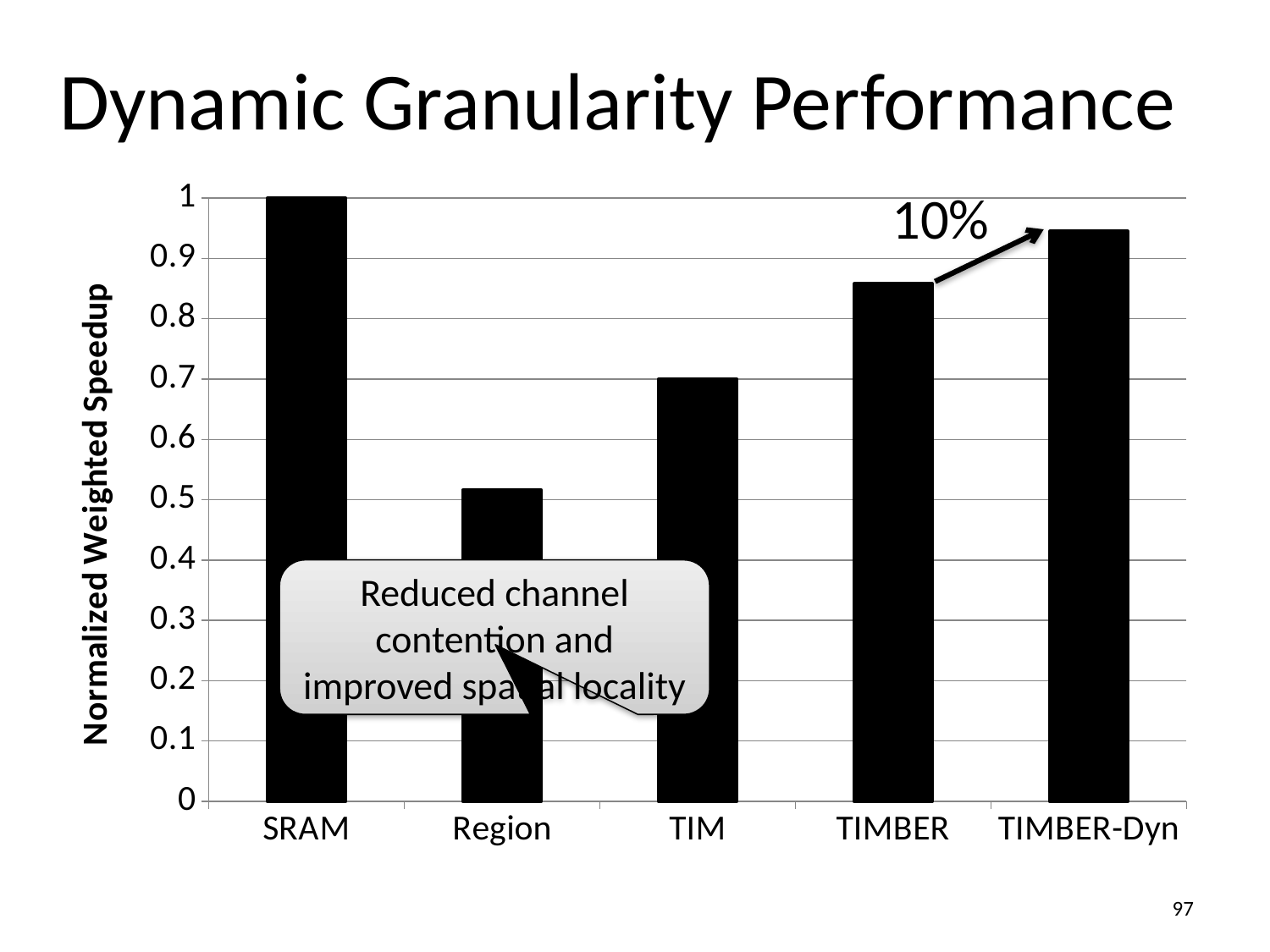
What kind of chart is shown on the slide? bar chart How many categories are shown on the x axis of the chart? 5 Is the value for TIMBER greater or less than 0.8? greater What is the label of the y axis of the chart? Normalized Weighted Speedup What is the normalized weighted speedup for SRAM? 1 Which has a higher normalized weighted speedup, Region or TIM? TIM Which category has the lowest normalized weighted speedup? Region Is the value for TIMBER-Dyn greater or less than 0.9? greater Is the value for TIM greater or less than 0.8? less Which category has the highest normalized weighted speedup? SRAM Which has a higher normalized weighted speedup, TIMBER or TIMBER-Dyn? TIMBER-Dyn